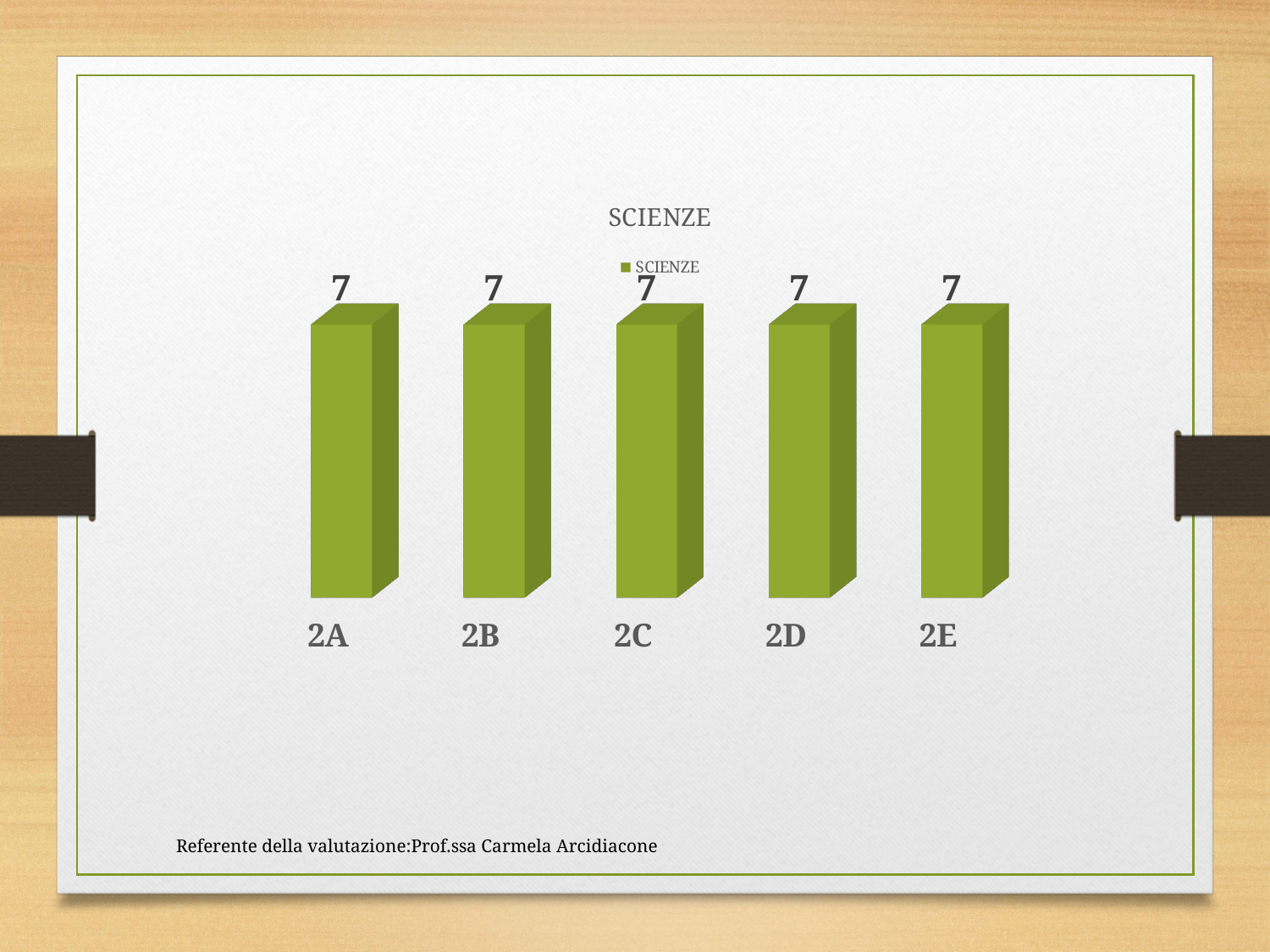
What is the value for 2A in the SCIENZE chart? 7 What kind of chart is shown on the slide? bar chart Is the value for 2D greater or less than 5? greater What is the value for 2E in the SCIENZE chart? 7 What is the title of the chart? SCIENZE What is the value for 2C in the SCIENZE chart? 7 Do the values rise, fall or stay the same from 2A to 2E? stay the same What is the difference between the values for 2B and 2D? 0 What is the name of the series listed in the legend? SCIENZE How many categories are shown on the x axis of the chart? 5 How many series does the legend list? 1